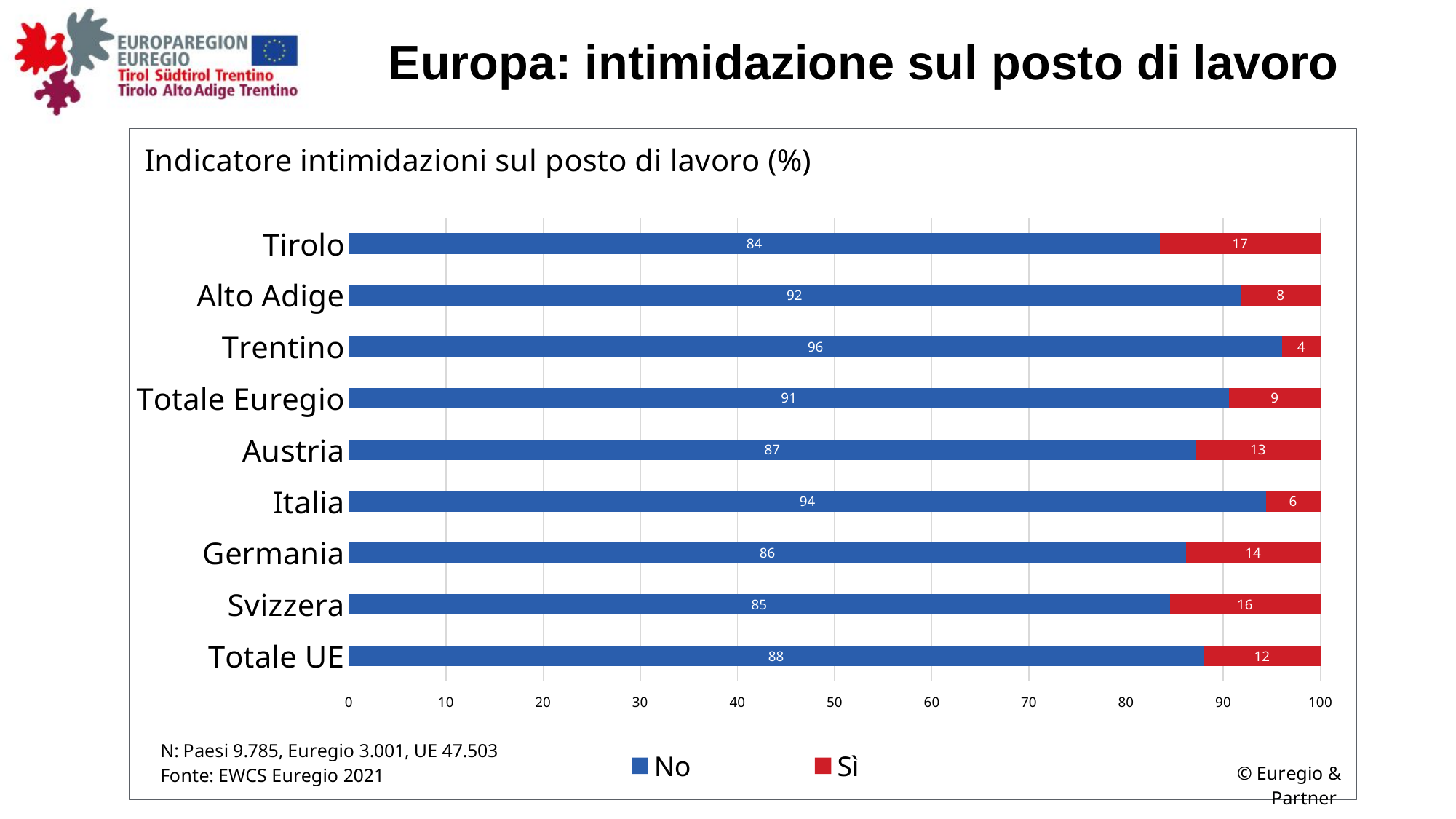
What is the title of the chart? Indicatore intimidazioni sul posto di lavoro (%) What is the difference between the 'Sì' values for Tirolo and Alto Adige? 9 What is the 'No' value for Trentino? 96 What kind of chart is shown? Stacked bar chart How many series does the legend list? 2 Which category has the lowest 'Sì' value? Trentino What is the 'Sì' value for Totale UE? 12 Which category has the highest 'Sì' value? Tirolo What is the 'Sì' value for Tirolo? 17 Is the 'No' value for Svizzera greater or less than 90? less How many categories are shown on the y axis? 9 Which has a larger 'No' value, Austria or Italia? Italia